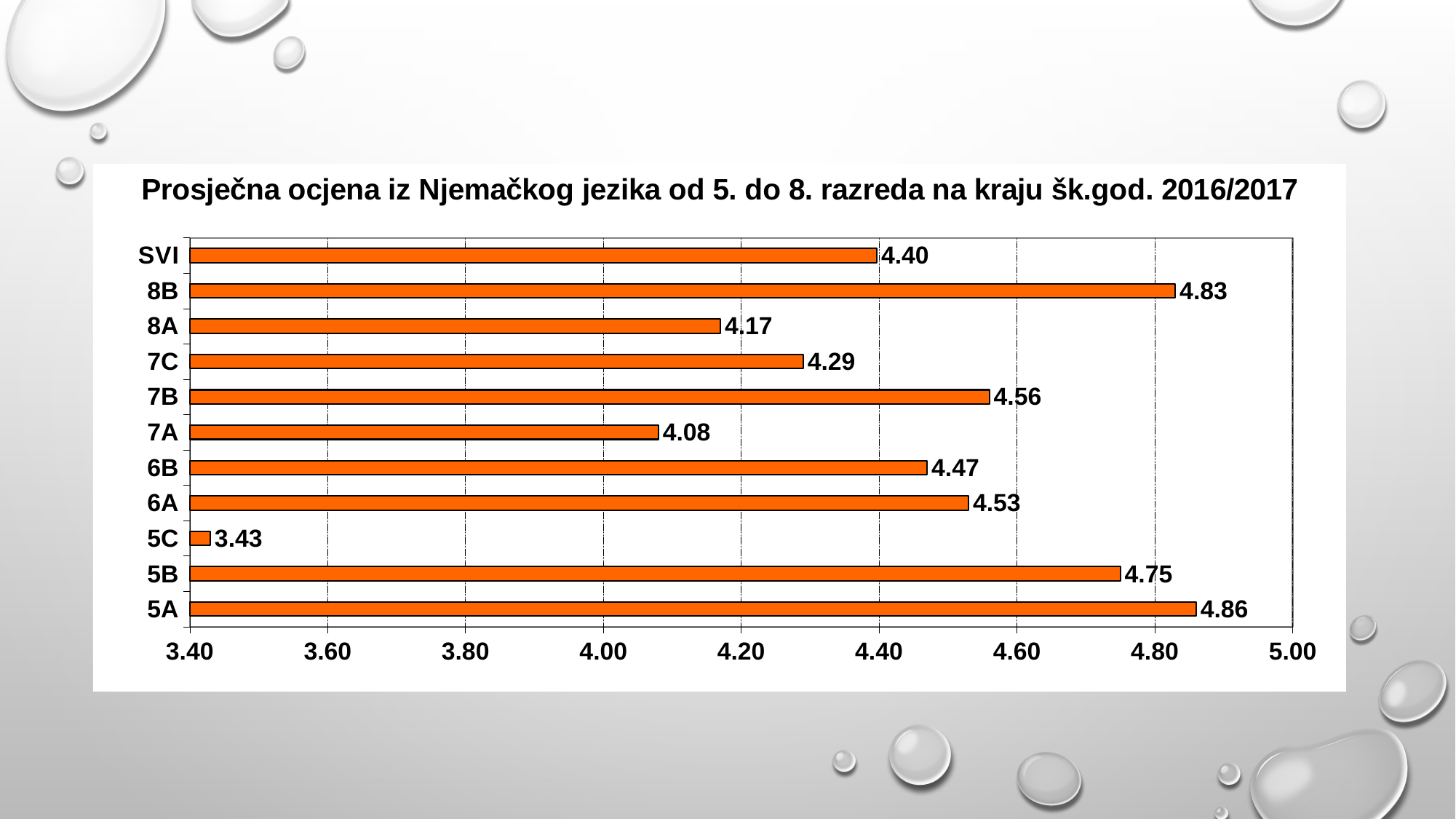
Which has a higher average grade, 6A or 6B? 6A What kind of chart is shown on the slide? bar chart Is the value for 7A greater or less than 4.20? less Which category has the lowest average grade? 5C What is the difference between the values for 8B and 8A? 0.66 What colour are the bars in the chart? orange What is the average grade for class 5A? 4.86 What is the average grade for class 7C? 4.29 What is the value shown for SVI? 4.40 How many categories are shown on the chart? 11 What is the difference between the values for 5A and 5C? 1.43 Which category has the highest average grade? 5A